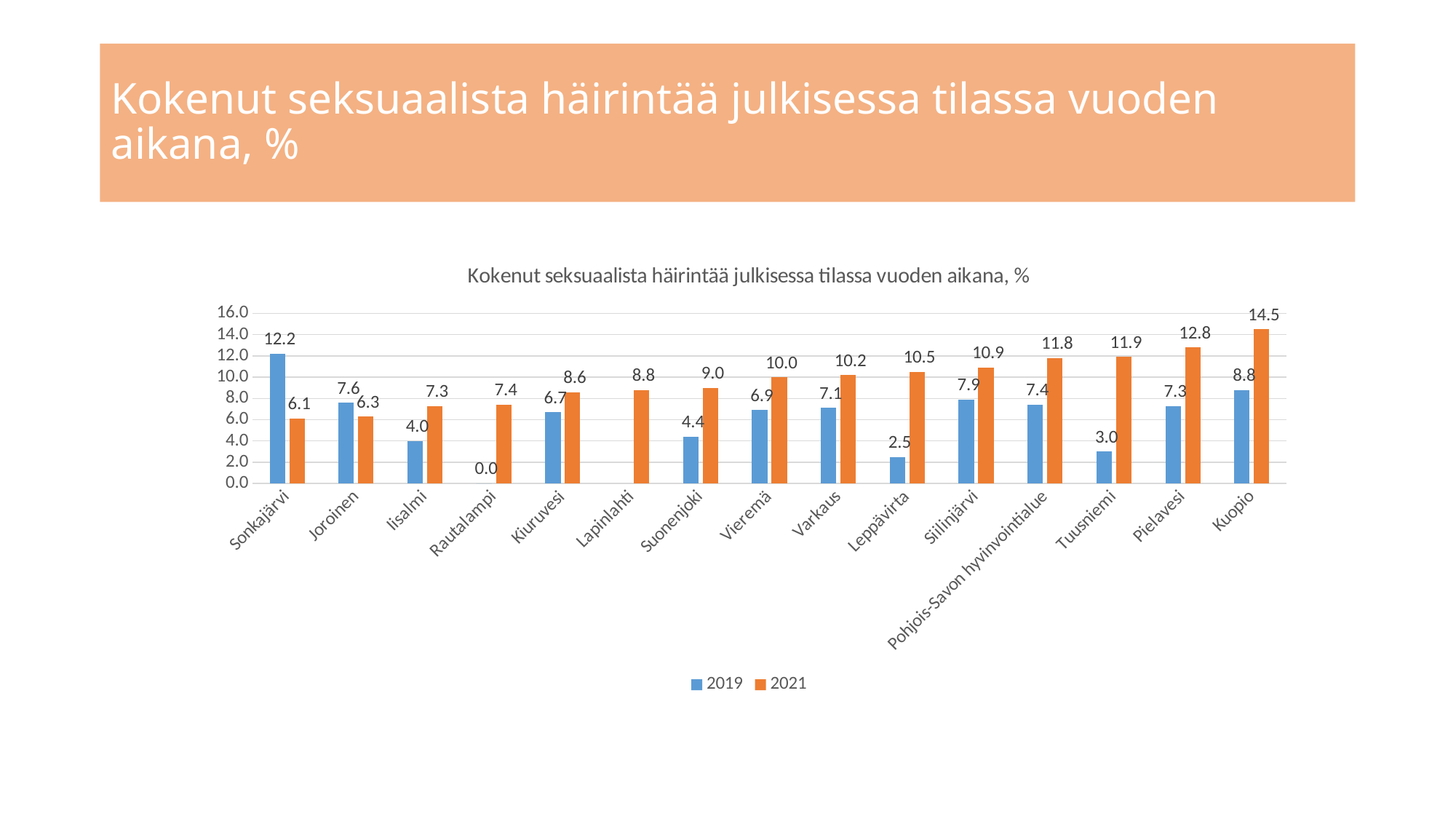
What is the 2019 value for Sonkajärvi? 12.2 What is the 2021 value for Kuopio? 14.5 What is the difference between the 2021 and 2019 values for Kuopio? 5.7 How many categories are shown on the x axis? 15 Which is larger for Sonkajärvi, the 2019 value or the 2021 value? 2019 What is the 2021 value for Pohjois-Savon hyvinvointialue? 11.8 What kind of chart is shown on the slide? Bar chart Which category has the lowest 2021 value? Sonkajärvi How many series does the legend list? 2 Which category has the highest 2019 value? Sonkajärvi Which category has the highest 2021 value? Kuopio Do the 2021 values rise or fall from left to right along the x axis? Rise